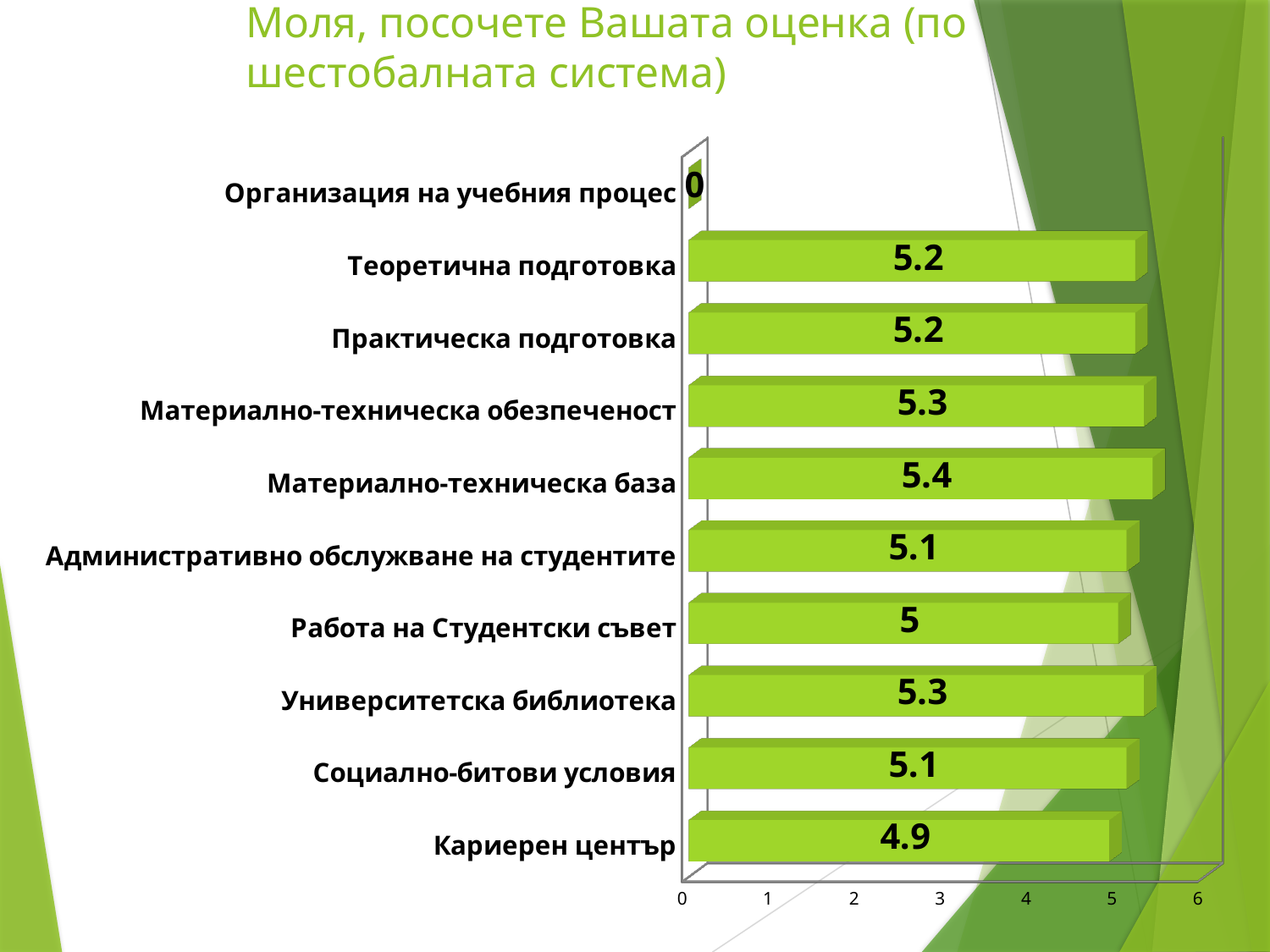
Which is larger, the value for Университетска библиотека or the value for Социално-битови условия? Университетска библиотека What kind of chart is shown on the slide? Bar chart What is the maximum value shown on the horizontal axis? 6 How many categories are shown in the chart? 10 What is the value for Теоретична подготовка? 5.2 Which category has the lowest value? Организация на учебния процес What is the value for Кариерен център? 4.9 What is the difference between the values for Материално-техническа база and Кариерен център? 0.5 What is the value for Организация на учебния процес? 0 Which category has the highest value? Материално-техническа база What is the value for Материално-техническа база? 5.4 What is the value for Работа на Студентски съвет? 5